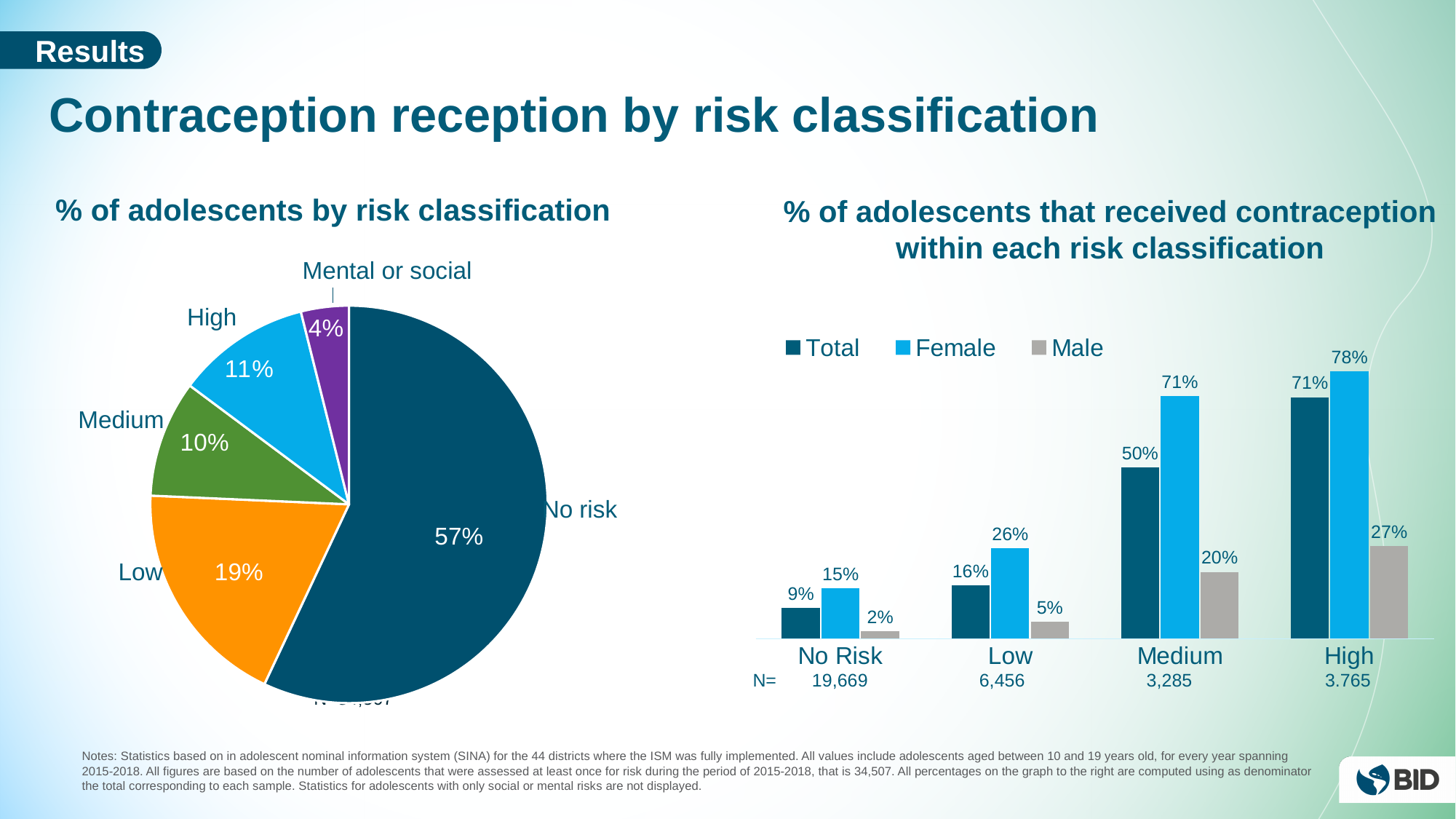
In the bar chart '% of adolescents that received contraception within each risk classification', which risk classification has the highest Female value? High What type of chart is shown on the right side of the slide? bar chart In the pie chart '% of adolescents by risk classification', what is the difference between the Low and High slices? 8% In the pie chart '% of adolescents by risk classification', what share of adolescents are classified as No risk? 57% In the pie chart '% of adolescents by risk classification', how many slices are there? 5 In the bar chart '% of adolescents that received contraception within each risk classification', what is the Female value for Medium? 71% In the bar chart '% of adolescents that received contraception within each risk classification', what is the difference between the Female and Male values for High? 51% In the bar chart '% of adolescents that received contraception within each risk classification', is the Total value for Low larger or smaller than the Total value for Medium? smaller In the pie chart '% of adolescents by risk classification', what is the value for the Medium slice? 10% In the bar chart '% of adolescents that received contraception within each risk classification', what is the Male value for No Risk? 2% In the bar chart '% of adolescents that received contraception within each risk classification', how many series does the legend list? 3 In the pie chart '% of adolescents by risk classification', which risk classification has the smallest slice? Mental or social